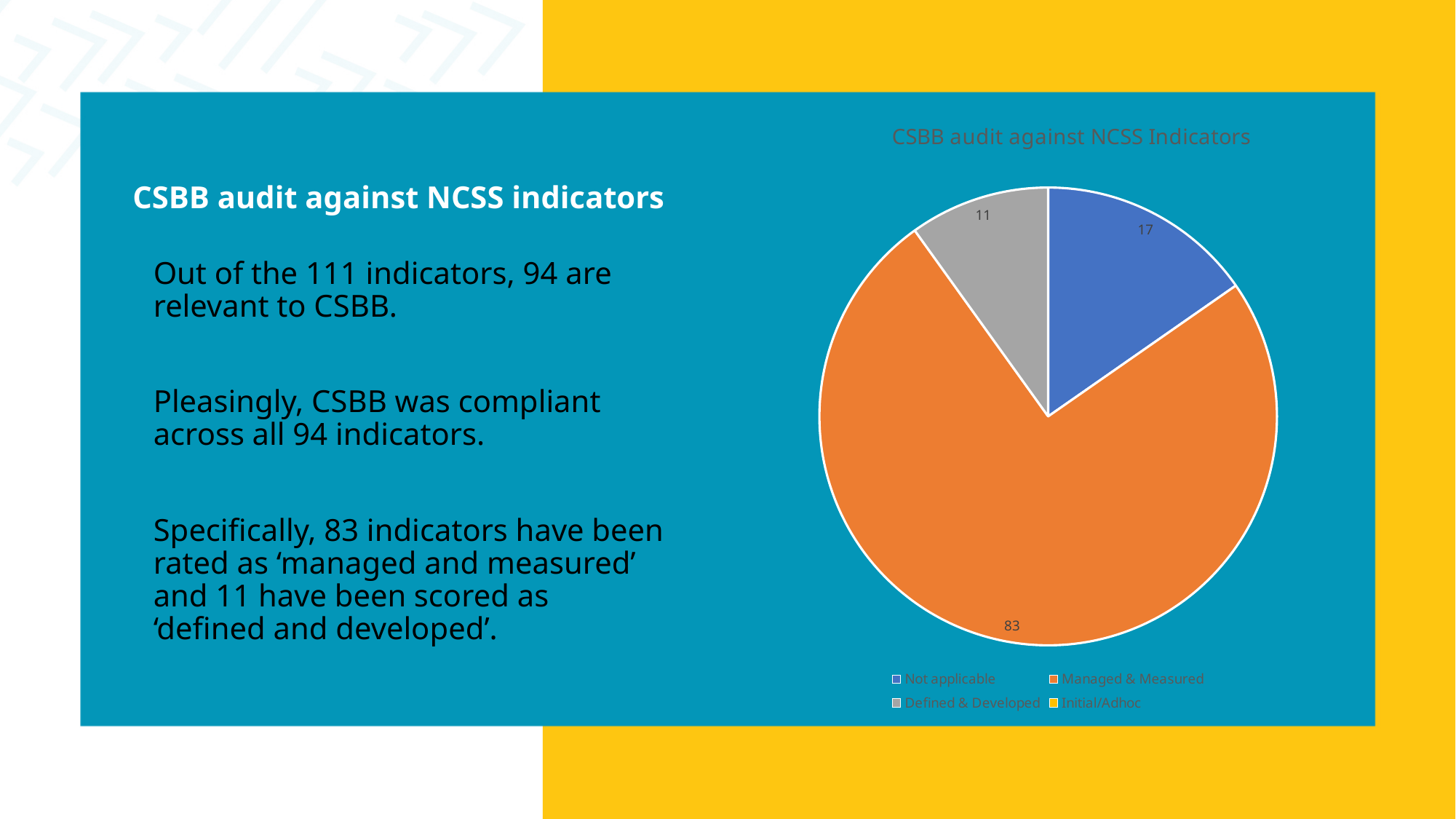
Which is larger, the Not applicable slice or the Defined & Developed slice? Not applicable Which labelled slice in the pie chart has the smallest value? Defined & Developed What is the difference between the Managed & Measured value and the Not applicable value? 66 What type of chart is shown on the slide? Pie chart What is the difference between the Not applicable value and the Defined & Developed value? 6 What colour is the Managed & Measured slice in the pie chart? Orange What is the value for Not applicable in the pie chart? 17 What is the title of the chart? CSBB audit against NCSS Indicators What is the value for Managed & Measured in the pie chart? 83 How many categories does the chart legend list? 4 Which category has the largest slice in the pie chart? Managed & Measured What is the value for Defined & Developed in the pie chart? 11